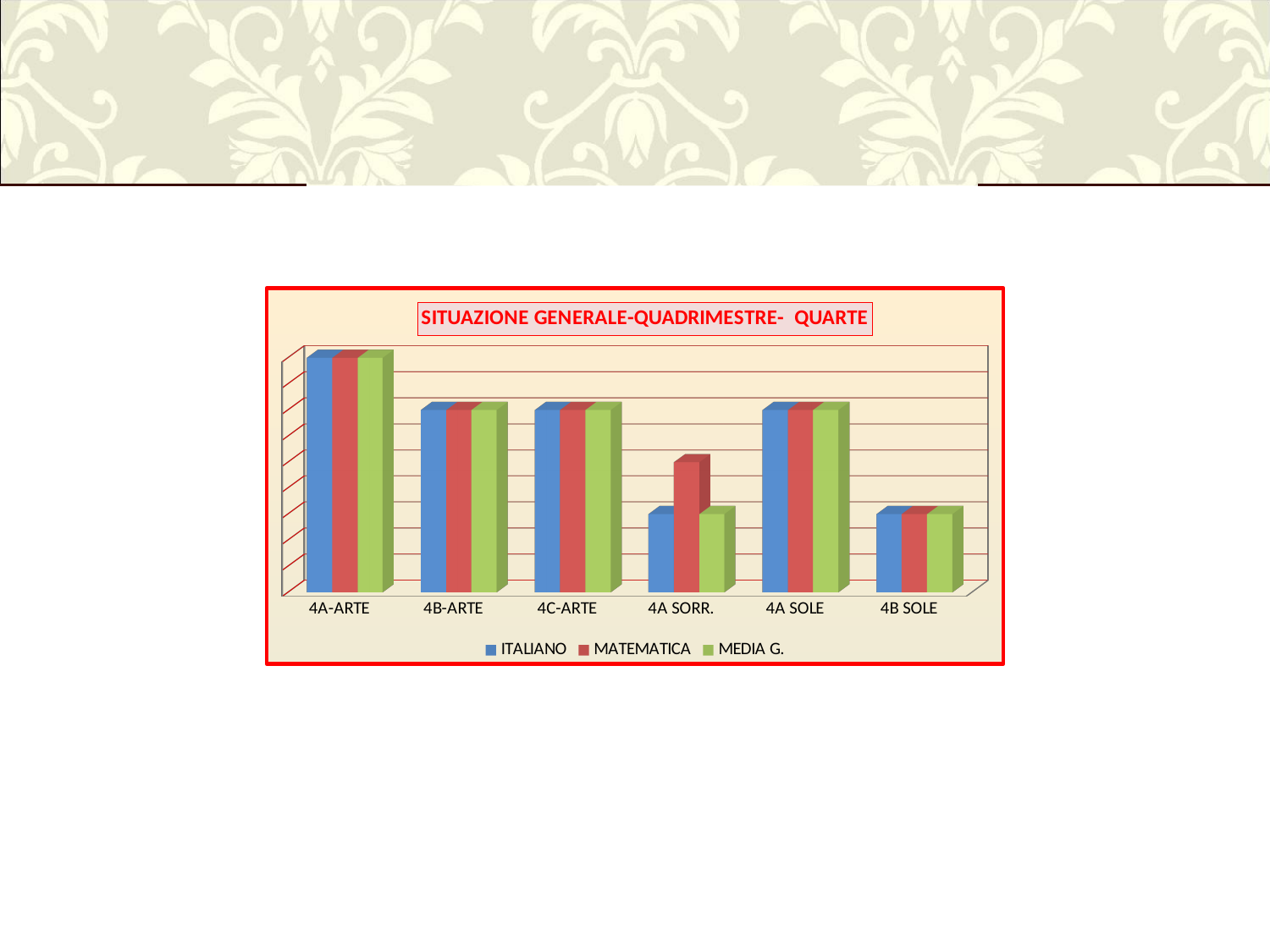
Which class has the highest ITALIANO value? 4A-ARTE Which has the larger ITALIANO value: 4A-ARTE or 4B-ARTE? 4A-ARTE Which series are listed in the legend? ITALIANO, MATEMATICA, MEDIA G. Which class has the lowest MATEMATICA value? 4B SOLE What is the title of the chart? SITUAZIONE GENERALE-QUADRIMESTRE- QUARTE Which has the larger MEDIA G. value: 4A SOLE or 4B SOLE? 4A SOLE What kind of chart is shown on the slide? bar chart How many series does the legend list? 3 Which has the larger MATEMATICA value: 4C-ARTE or 4A SORR.? 4C-ARTE Which class has the highest MEDIA G. value? 4A-ARTE How many classes (categories) are shown on the x axis? 6